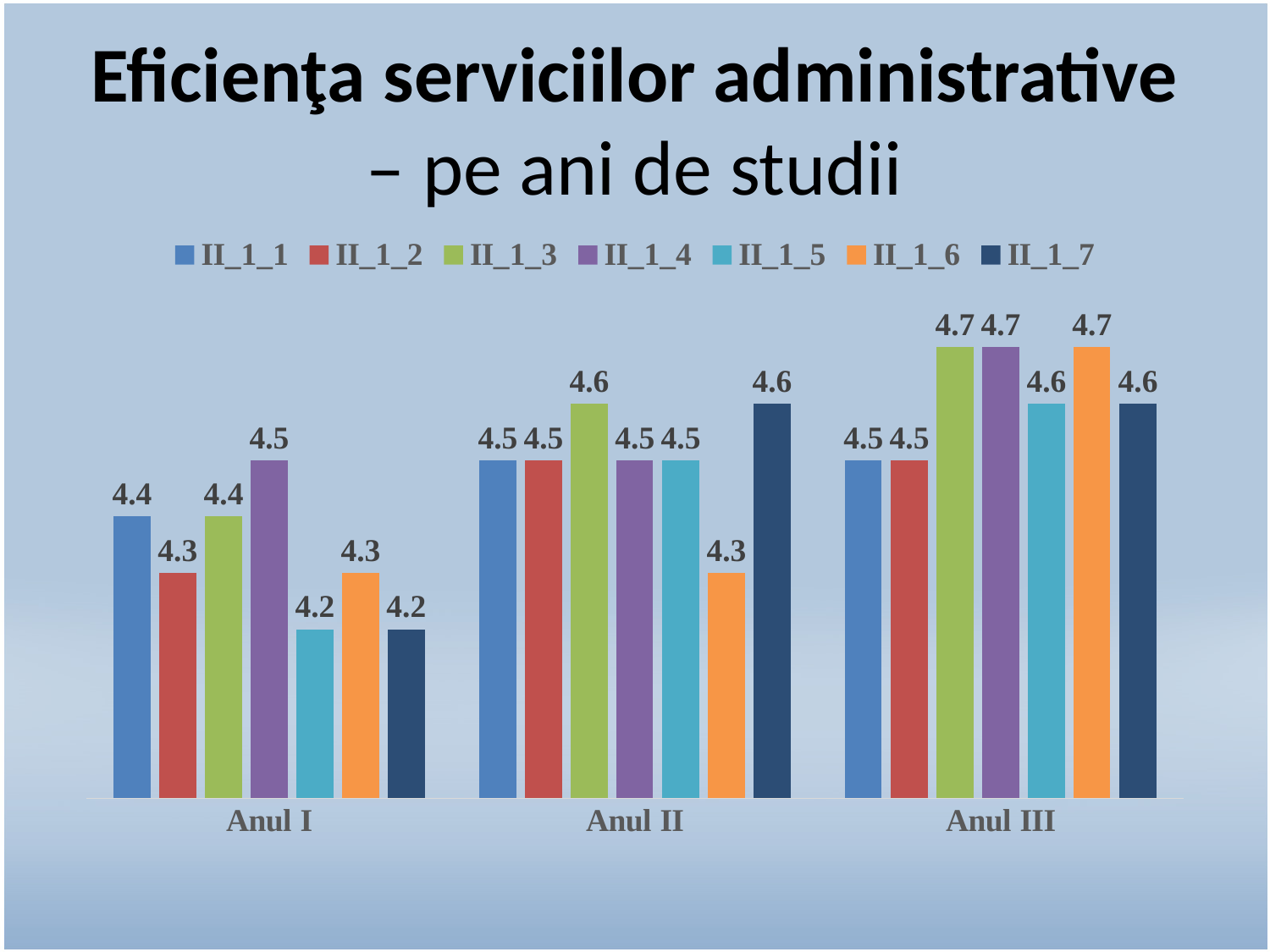
What is the value for II_1_5 in Anul III? 4.6 Which series has the highest value in Anul I? II_1_4 Which series has the lowest value in Anul II? II_1_6 How many series does the legend list? 7 What is the value for II_1_4 in Anul I? 4.5 What is the difference between the II_1_3 values for Anul III and Anul I? 0.3 What kind of chart is shown on the slide? Bar chart What colour are the bars for the II_1_6 series? Orange Which is larger: II_1_7 in Anul I or II_1_7 in Anul II? II_1_7 in Anul II How many year-of-study categories are shown on the x axis? 3 Does the value for II_1_3 rise or fall from Anul I to Anul III? Rise What is the value for II_1_6 in Anul II? 4.3